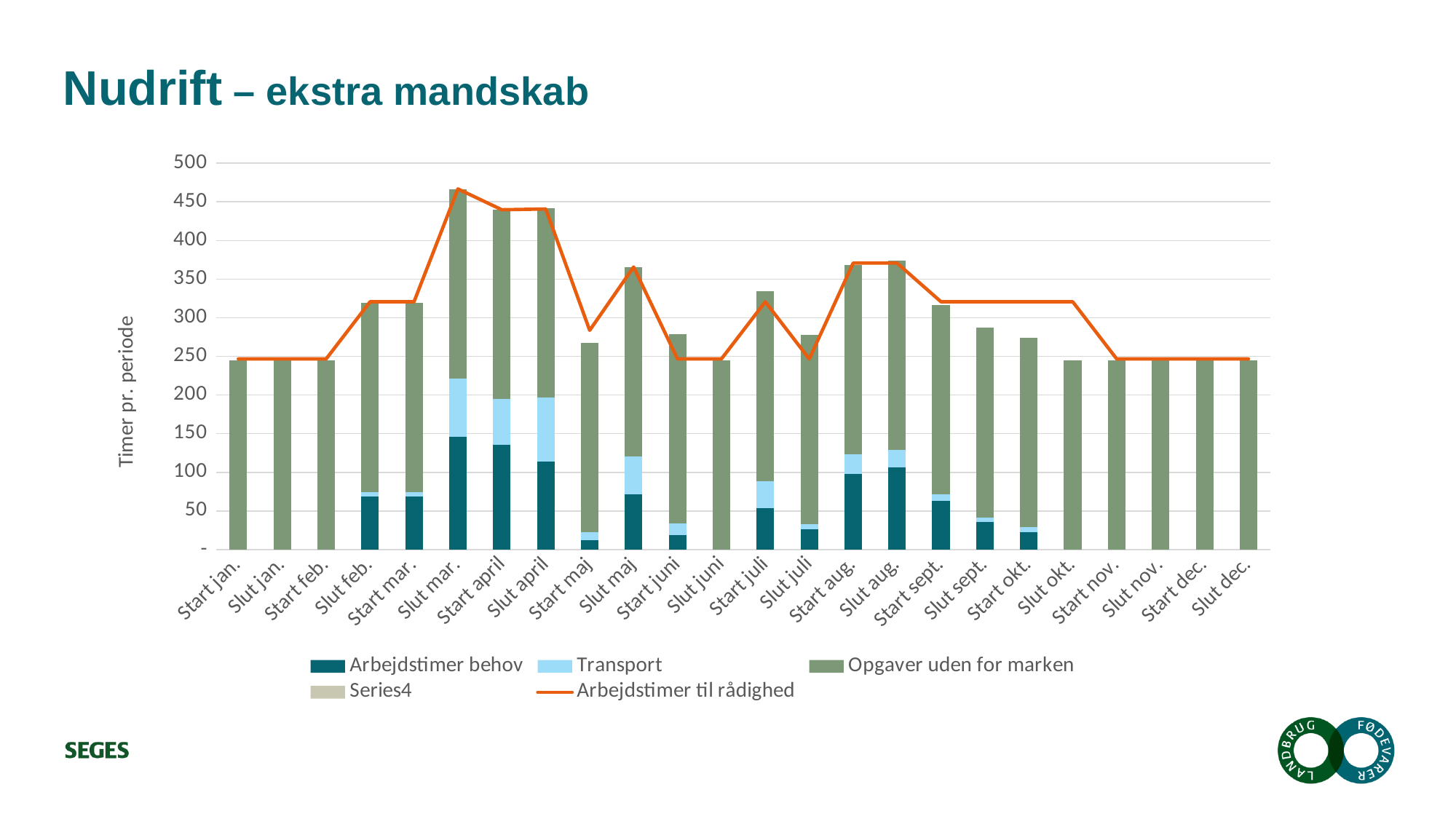
Is the total stacked bar for Slut okt. greater or less than 300? less Is the total stacked bar for Start aug. greater or less than 350? greater How many series does the legend list? 5 What is the label of the y axis? Timer pr. periode Which series is drawn as an orange line? Arbejdstimer til rådighed Which has the taller stacked bar, Slut maj or Start juni? Slut maj How many categories are shown along the x axis? 24 Is the Arbejdstimer behov value for Slut mar. greater or less than 100? greater Which has the taller stacked bar, Start april or Start maj? Start april Which category has the tallest stacked bar? Slut mar. What kind of chart is shown on the slide? Stacked bar chart with a line